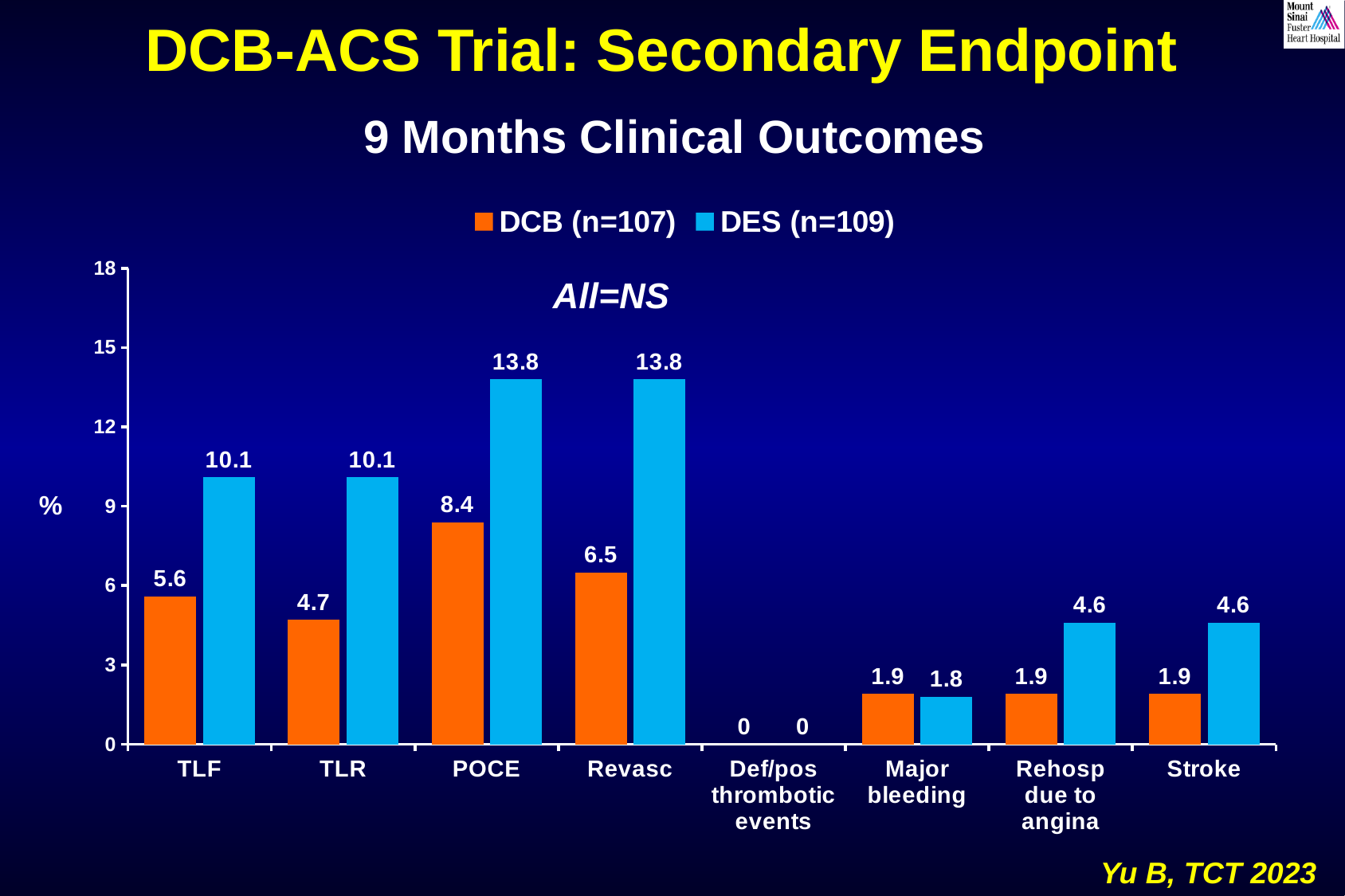
What is the DCB (n=107) value for Major bleeding? 1.9 What is the difference between the DES (n=109) and DCB (n=107) values for TLR? 5.4 How many categories are shown on the x axis? 8 What is the label on the y axis? % What is the DCB (n=107) value for TLF? 5.6 What kind of chart is shown on the slide? Bar chart Which category has the lowest DCB (n=107) value? Def/pos thrombotic events For Major bleeding, which series has the larger value, DCB (n=107) or DES (n=109)? DCB (n=107) For Stroke, which series has the larger value, DCB (n=107) or DES (n=109)? DES (n=109) What is the DES (n=109) value for POCE? 13.8 Which category has the highest DES (n=109) value? POCE and Revasc (both 13.8) How many series does the legend list? 2